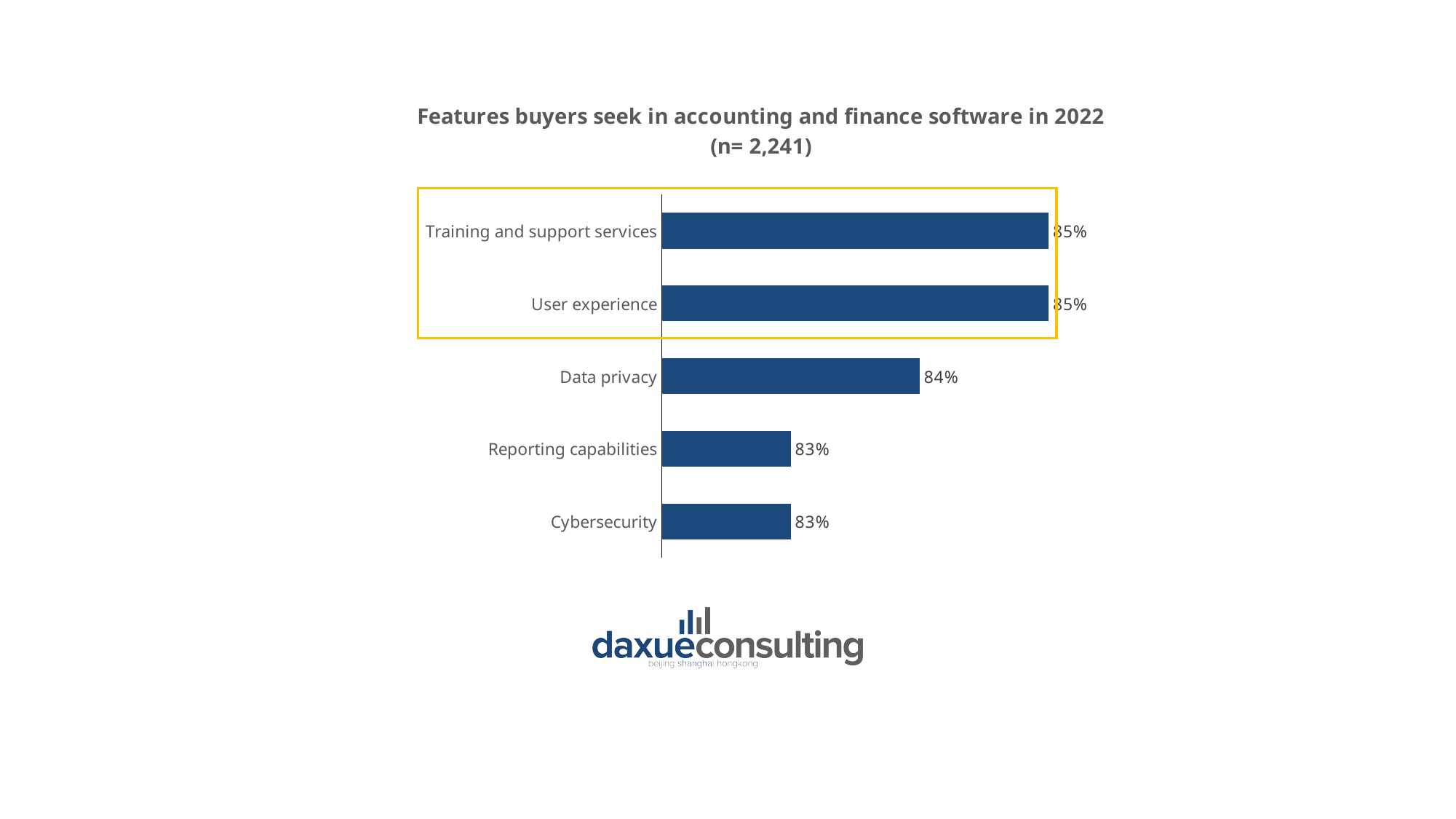
What is the value for Reporting capabilities? 83% What is the lowest value shown in the chart? 83% What is the value for Data privacy? 84% What is the highest value shown in the chart? 85% What is the value for Cybersecurity? 83% What is the sample size (n) given in the chart title? 2,241 What is the value for Training and support services? 85% What kind of chart is shown on the slide? Bar chart What is the difference between the value for Training and support services and the value for Cybersecurity? 2 percentage points What is the value for User experience? 85% How many categories are shown in the chart? 5 Which has a larger value, Data privacy or Reporting capabilities? Data privacy